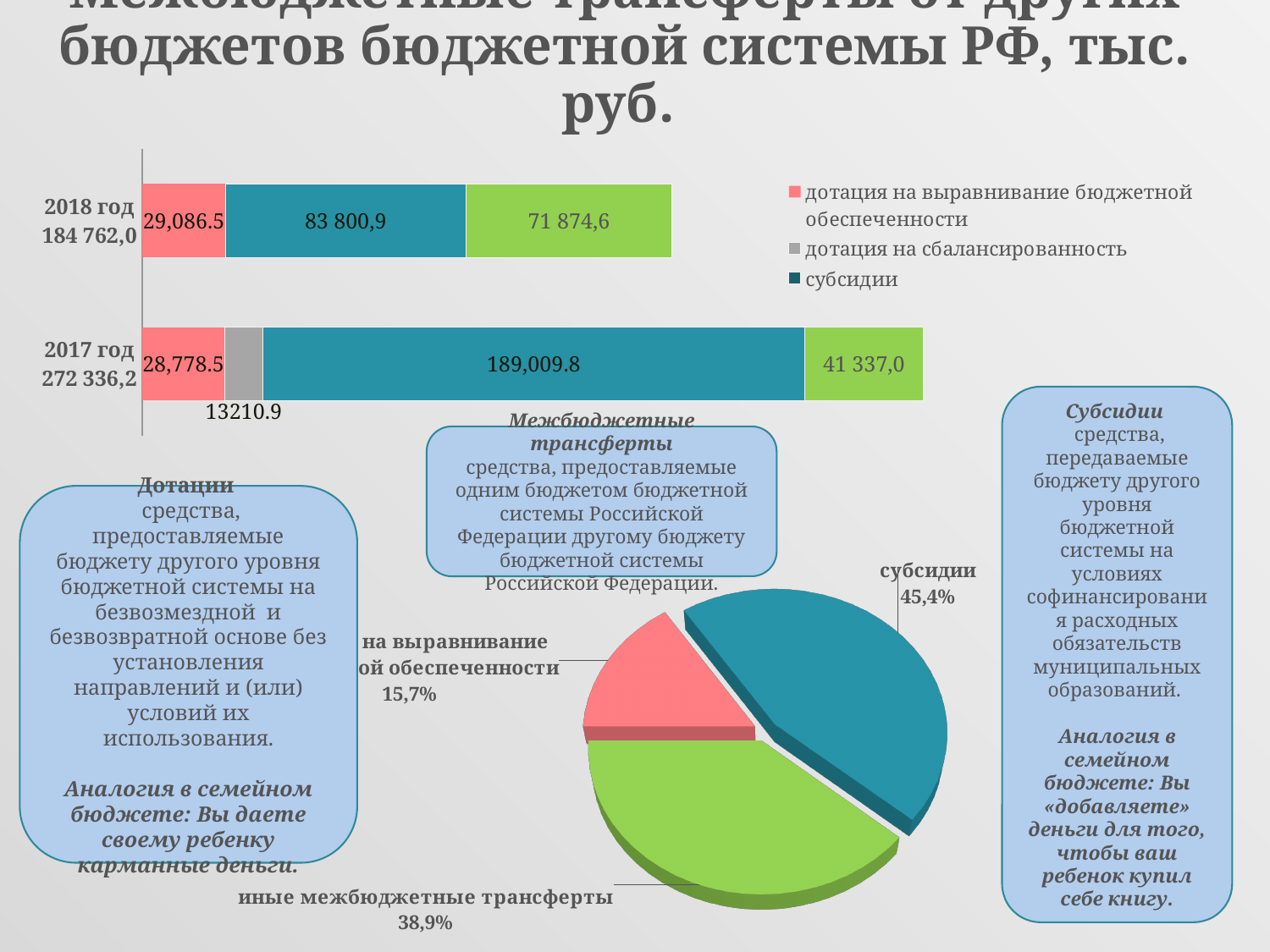
In the stacked bar chart, what is the value of субсидии for 2018 год? 83 800,9 In the pie chart, which slice is the largest? субсидии What kind of chart is the upper chart on the slide? bar chart In the pie chart, what share does субсидии have? 45,4% In the stacked bar chart, what is the difference between the totals for 2017 год and 2018 год? 87 574,2 In the stacked bar chart, what is the value of субсидии for 2017 год? 189,009.8 In the stacked bar chart, what is the total for 2018 год? 184 762,0 How many slices does the pie chart have? 3 In the stacked bar chart, what is the total for 2017 год? 272 336,2 How many series does the legend of the stacked bar chart list? 3 In the stacked bar chart, which year has the larger value for субсидии, 2017 год or 2018 год? 2017 год In the stacked bar chart, what is the value of дотация на сбалансированность for 2017 год? 13210.9